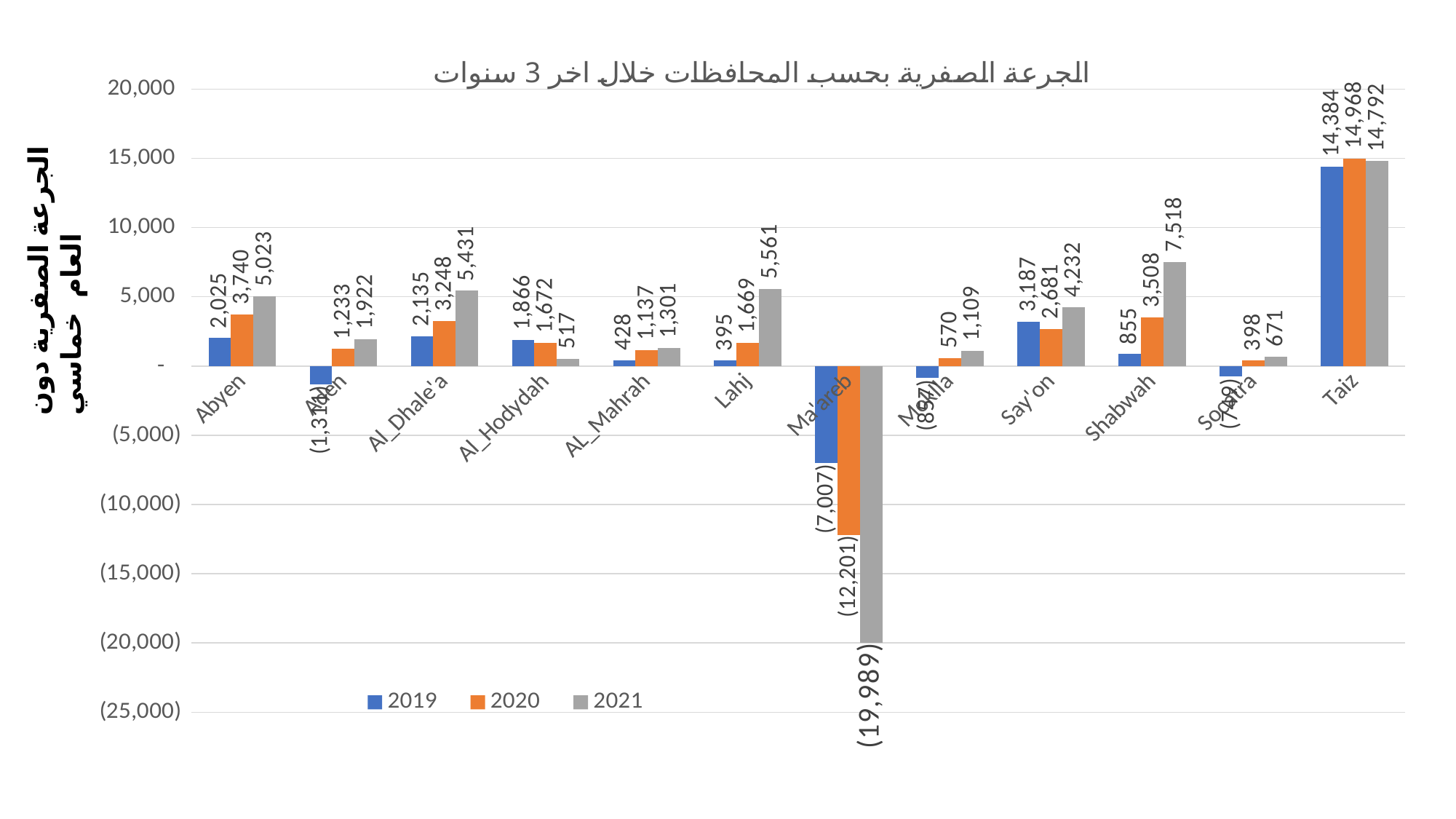
What is the value for Taiz in 2020? 14,968 What is the difference between the 2021 and 2019 values for Shabwah? 6,663 Which category has the lowest value in 2020? Ma'areb Which is larger, the 2021 value for Abyen or the 2021 value for Al_Dhale'a? Al_Dhale'a What kind of chart is shown? bar chart Do the values for Al_Hodydah rise or fall from 2019 to 2021? fall How many series does the legend list? 3 What is the value for Al_Hodydah in 2019? 1,866 Which category has the highest value in 2021? Taiz How many categories are shown on the x axis? 12 What is the value for Ma'areb in 2021? (19,989) What is the value for Lahj in 2021? 5,561